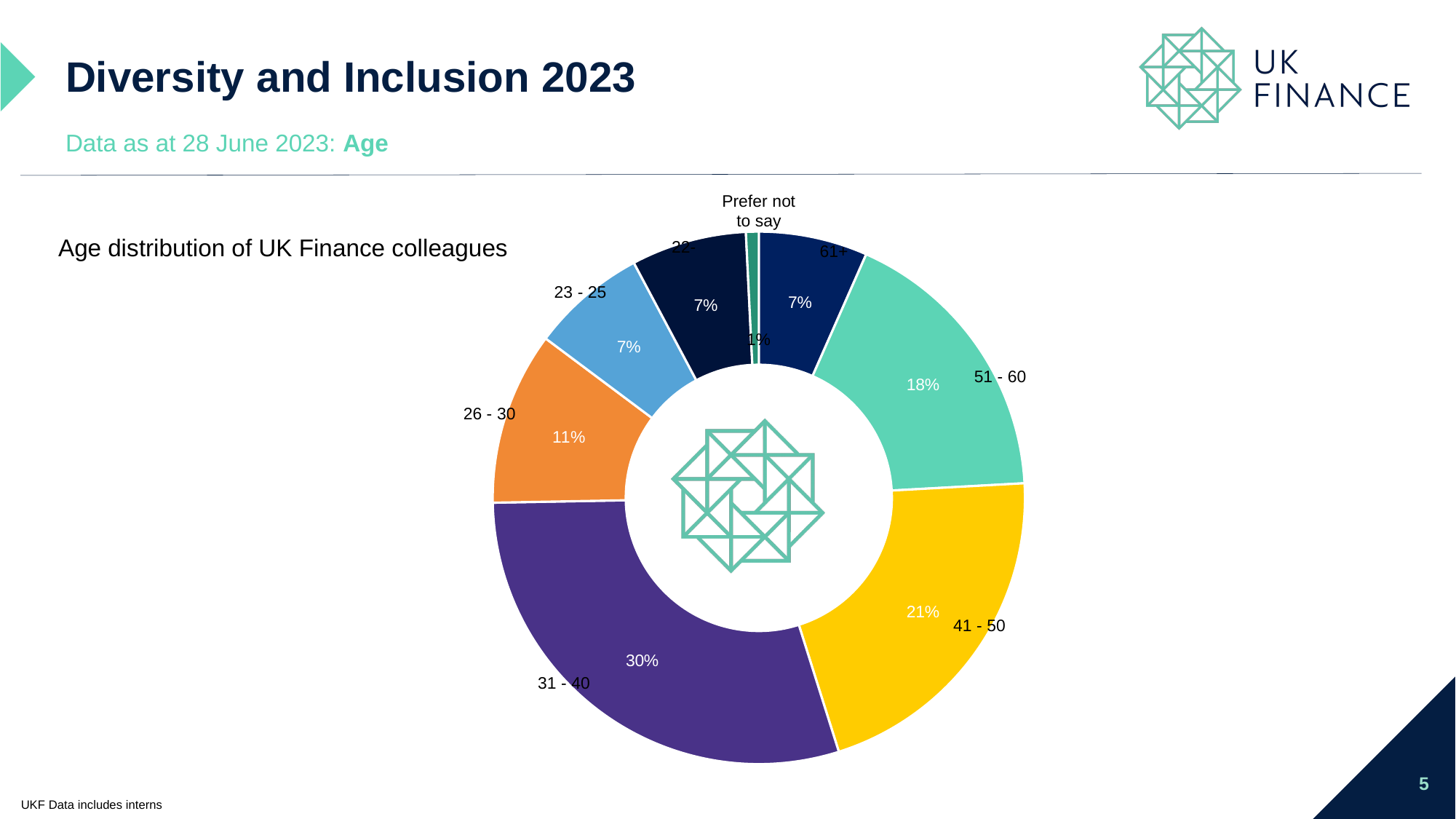
Which age group has the largest share of colleagues? 31 - 40 Which category has the smallest share in the chart? Prefer not to say What share of colleagues are aged 51 - 60? 18% What is the difference in percentage points between the 31 - 40 and 41 - 50 age groups? 9 What percentage of colleagues chose 'Prefer not to say' for their age? 1% What percentage of colleagues are aged 26 - 30? 11% What percentage of colleagues are aged 61+? 7% Which age group has a larger share: 51 - 60 or 26 - 30? 51 - 60 How many categories are shown in the age distribution chart? 8 What percentage of UK Finance colleagues are aged 31 - 40? 30% What type of chart is used to show the age distribution? Doughnut (pie) chart What percentage of colleagues are in the 41 - 50 age group? 21%